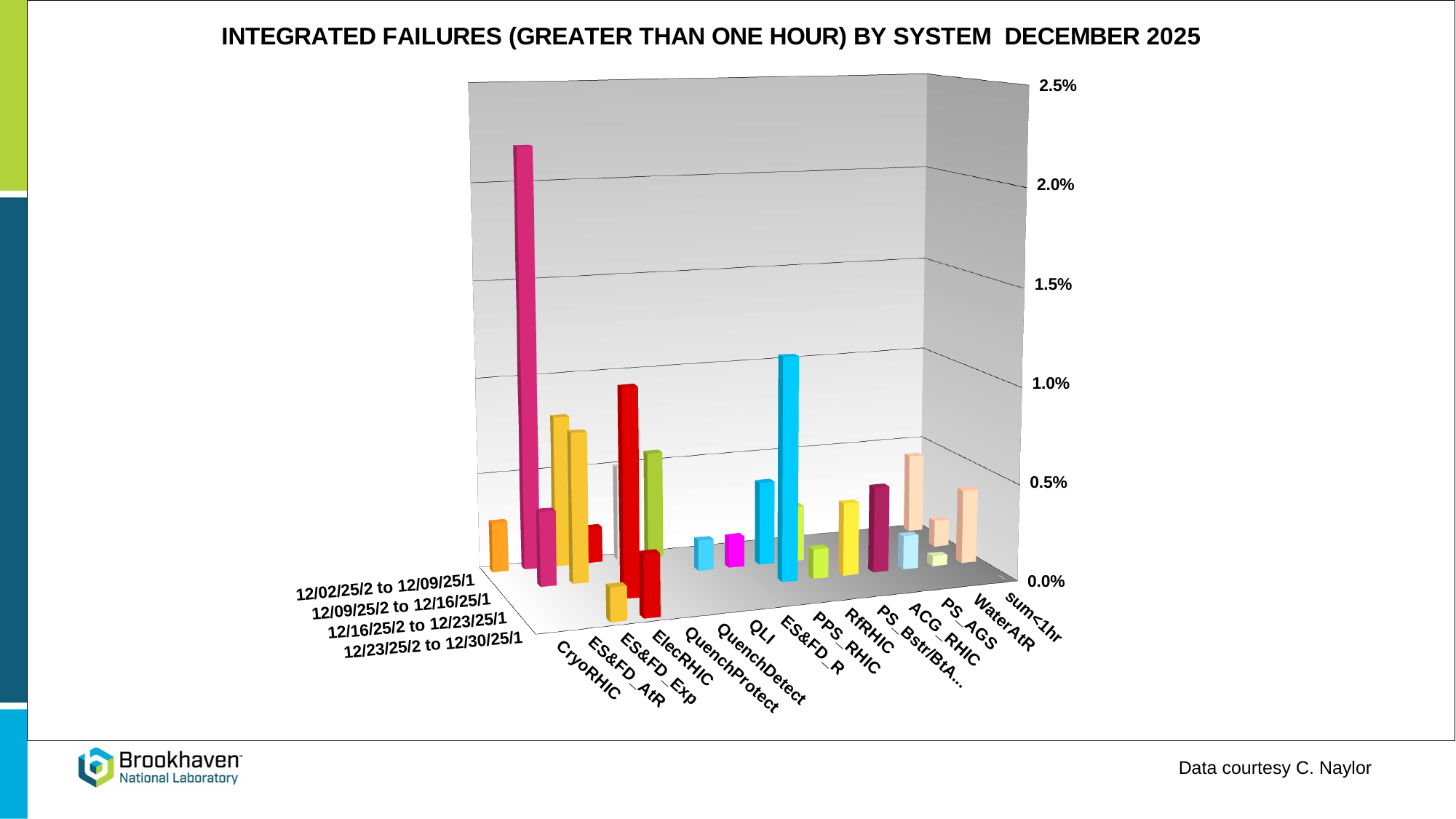
How many weekly time periods (series) are plotted along the depth axis of the chart? 4 Is the tallest bar in the chart greater or less than 2.5%? less How many system categories are listed along the x axis of the chart? 15 What is the highest value shown on the vertical axis of the chart? 2.5% Which category is listed first on the x axis of the chart? CryoRHIC Which category is listed last on the x axis of the chart? sum<1hr Which time period is listed last (at the front) on the depth axis of the chart? 12/23/25/2 to 12/30/25/1 What kind of chart is shown on the slide? bar chart What is the title of the chart? INTEGRATED FAILURES (GREATER THAN ONE HOUR) BY SYSTEM DECEMBER 2025 Is the tallest bar in the chart greater or less than 1.5%? greater Which time period is listed first (at the back) on the depth axis of the chart? 12/02/25/2 to 12/09/25/1